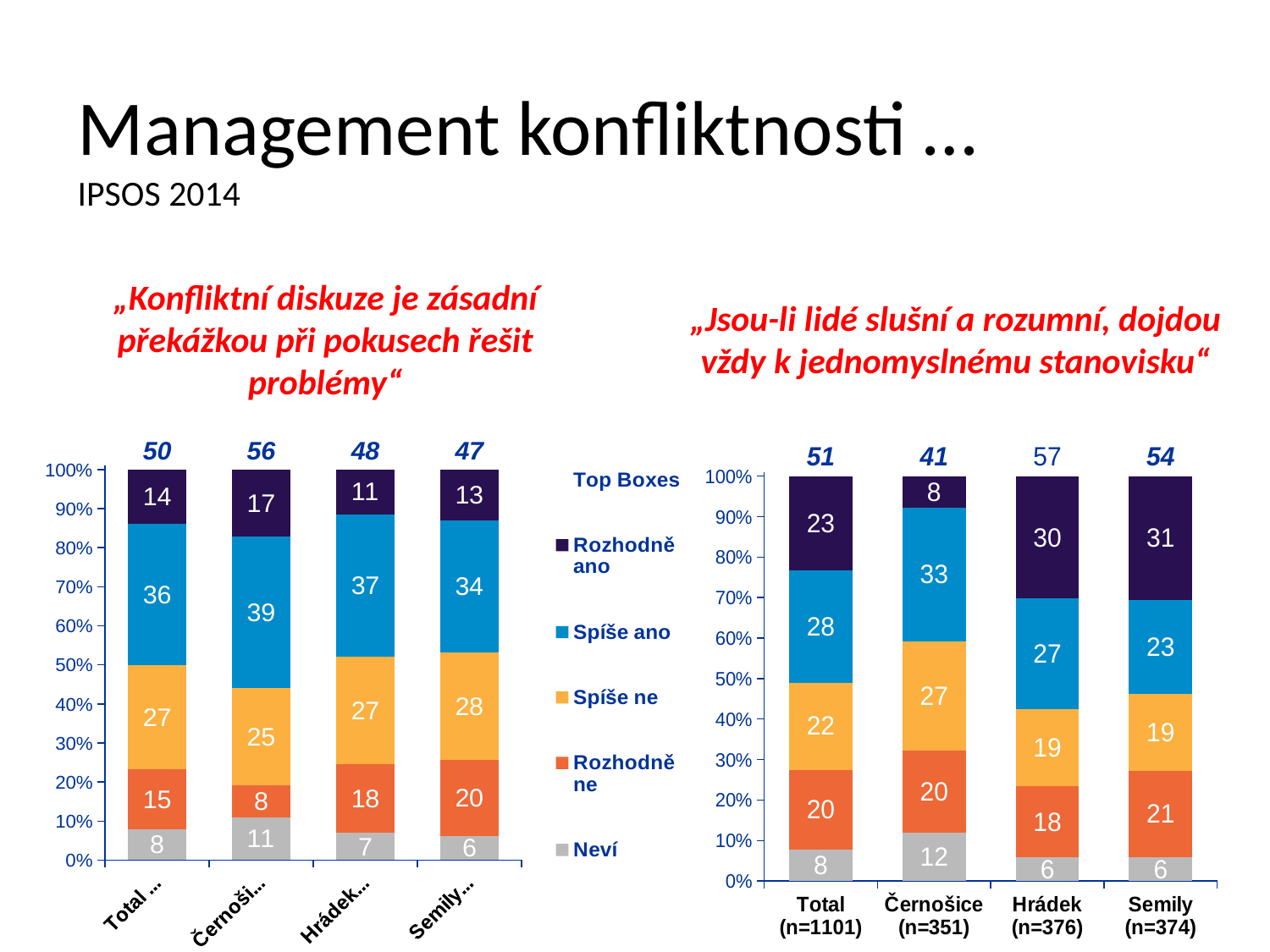
In the left chart ("Konfliktní diskuze je zásadní překážkou..."), what is the Top Boxes value shown above the Hrádek bar? 48 What kind of chart is the left chart ("Konfliktní diskuze je zásadní překážkou...")? Stacked bar chart In the right chart ("Jsou-li lidé slušní a rozumní..."), which category has the lowest Top Boxes value shown above the bars? Černošice In the right chart ("Jsou-li lidé slušní a rozumní..."), what is the "Rozhodně ano" value for Semily? 31 In the left chart ("Konfliktní diskuze je zásadní překážkou..."), which category has the highest Top Boxes value shown above the bars? Černošice In the left chart ("Konfliktní diskuze je zásadní překážkou..."), what is the "Spíše ano" value for Černošice? 39 How many series does the legend list? 6 In the right chart ("Jsou-li lidé slušní a rozumní..."), what is the "Neví" value for Černošice? 12 In the left chart ("Konfliktní diskuze je zásadní překážkou..."), which is larger: the "Rozhodně ne" value for Semily or for Černošice? Semily In the right chart ("Jsou-li lidé slušní a rozumní..."), what is the difference between the "Rozhodně ano" values for Hrádek and Černošice? 22 Which legend entry is shown in the darkest (navy) colour? Rozhodně ano How many categories are shown on the x axis of the right chart ("Jsou-li lidé slušní a rozumní...")? 4